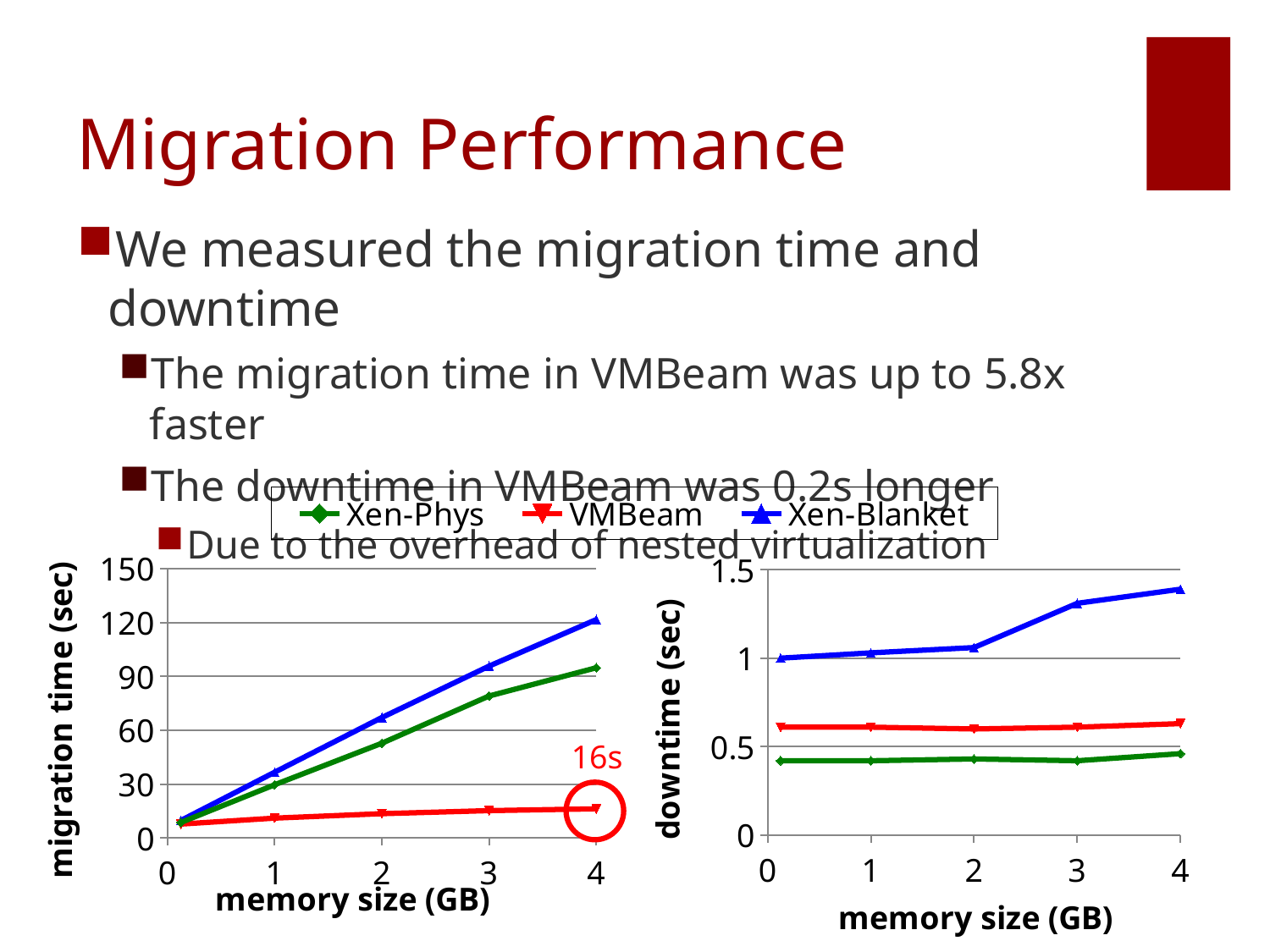
In the left chart (migration time), is the value for Xen-Blanket at 4 GB greater or less than 90? greater What kind of chart is the left chart (migration time)? line chart In the left chart (migration time), which series has the highest migration time at 4 GB? Xen-Blanket What is the x-axis label of the right chart (downtime)? memory size (GB) In the left chart (migration time), is the value for Xen-Phys at 2 GB greater or less than 60? less In the left chart (migration time), what is the migration time for VMBeam at 4 GB memory size? 16s In the right chart (downtime), which is larger at 2 GB: VMBeam or Xen-Phys? VMBeam In the left chart (migration time), which series has the lowest migration time at 4 GB? VMBeam In the right chart (downtime), which series has the highest downtime at 4 GB? Xen-Blanket In the right chart (downtime), is the value for Xen-Blanket at 4 GB greater or less than 1? greater In the left chart (migration time), does the migration time for Xen-Blanket rise or fall as memory size increases? rise How many series does the legend list? 3